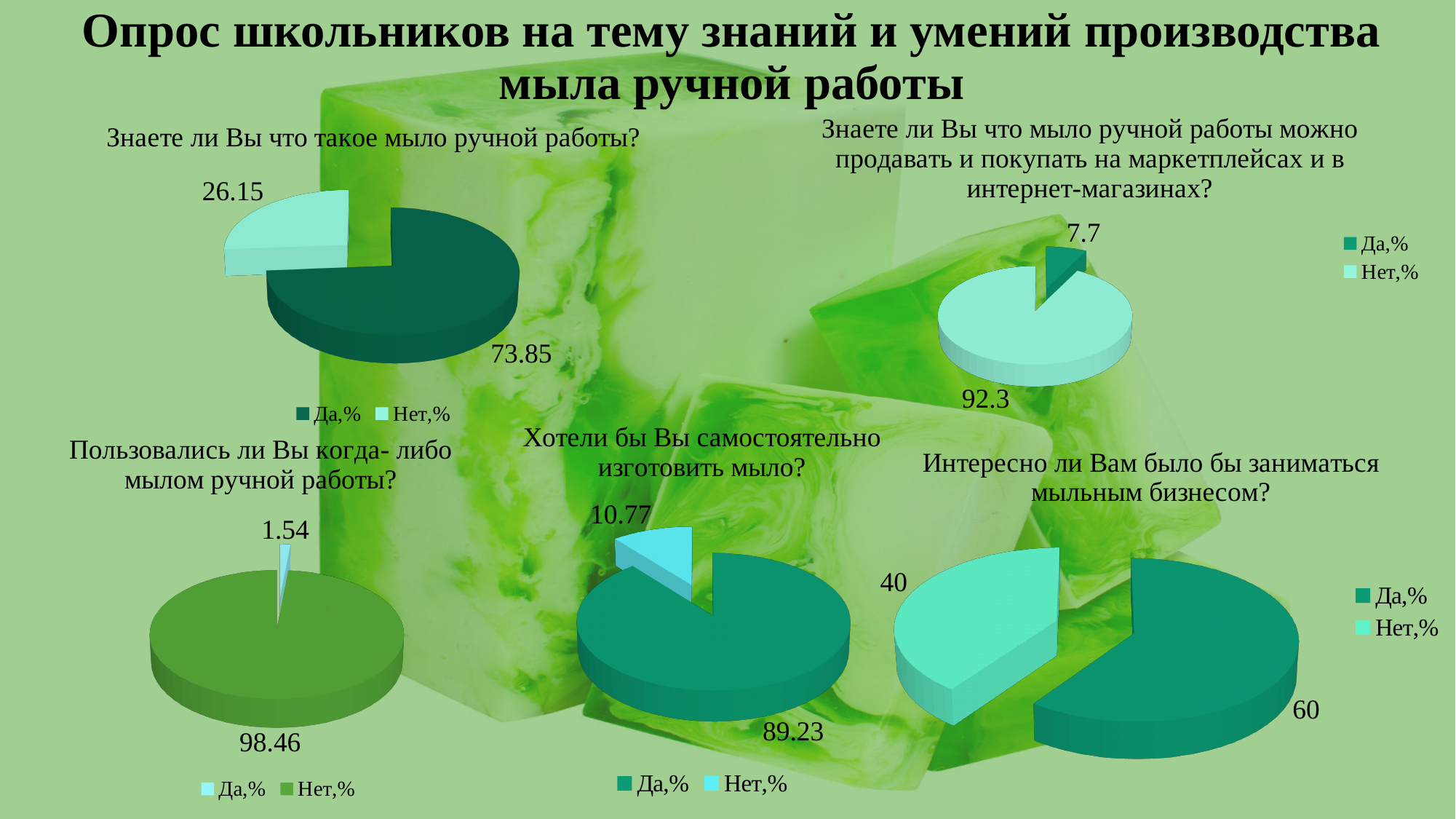
In the chart 'Интересно ли Вам было бы заниматься мыльным бизнесом?', what is the value for 'Да,%'? 60 What kind of chart is used for 'Интересно ли Вам было бы заниматься мыльным бизнесом?'? Pie chart In the chart 'Знаете ли Вы что мыло ручной работы можно продавать и покупать на маркетплейсах и в интернет-магазинах?', which category is the smallest? Да,% In the chart 'Знаете ли Вы что такое мыло ручной работы?', what is the value for 'Да,%'? 73.85 In the chart 'Знаете ли Вы что мыло ручной работы можно продавать и покупать на маркетплейсах и в интернет-магазинах?', what is the value for 'Нет,%'? 92.3 In the chart 'Знаете ли Вы что такое мыло ручной работы?', what is the value for 'Нет,%'? 26.15 In the chart 'Хотели бы Вы самостоятельно изготовить мыло?', what is the value for 'Нет,%'? 10.77 In the chart 'Интересно ли Вам было бы заниматься мыльным бизнесом?', which is larger, 'Да,%' or 'Нет,%'? Да,% How many charts are shown on the slide? 5 In the chart 'Пользовались ли Вы когда- либо мылом ручной работы?', which category is the largest? Нет,% In the chart 'Пользовались ли Вы когда- либо мылом ручной работы?', what is the value for 'Да,%'? 1.54 In the chart 'Хотели бы Вы самостоятельно изготовить мыло?', what is the difference between 'Да,%' and 'Нет,%'? 78.46